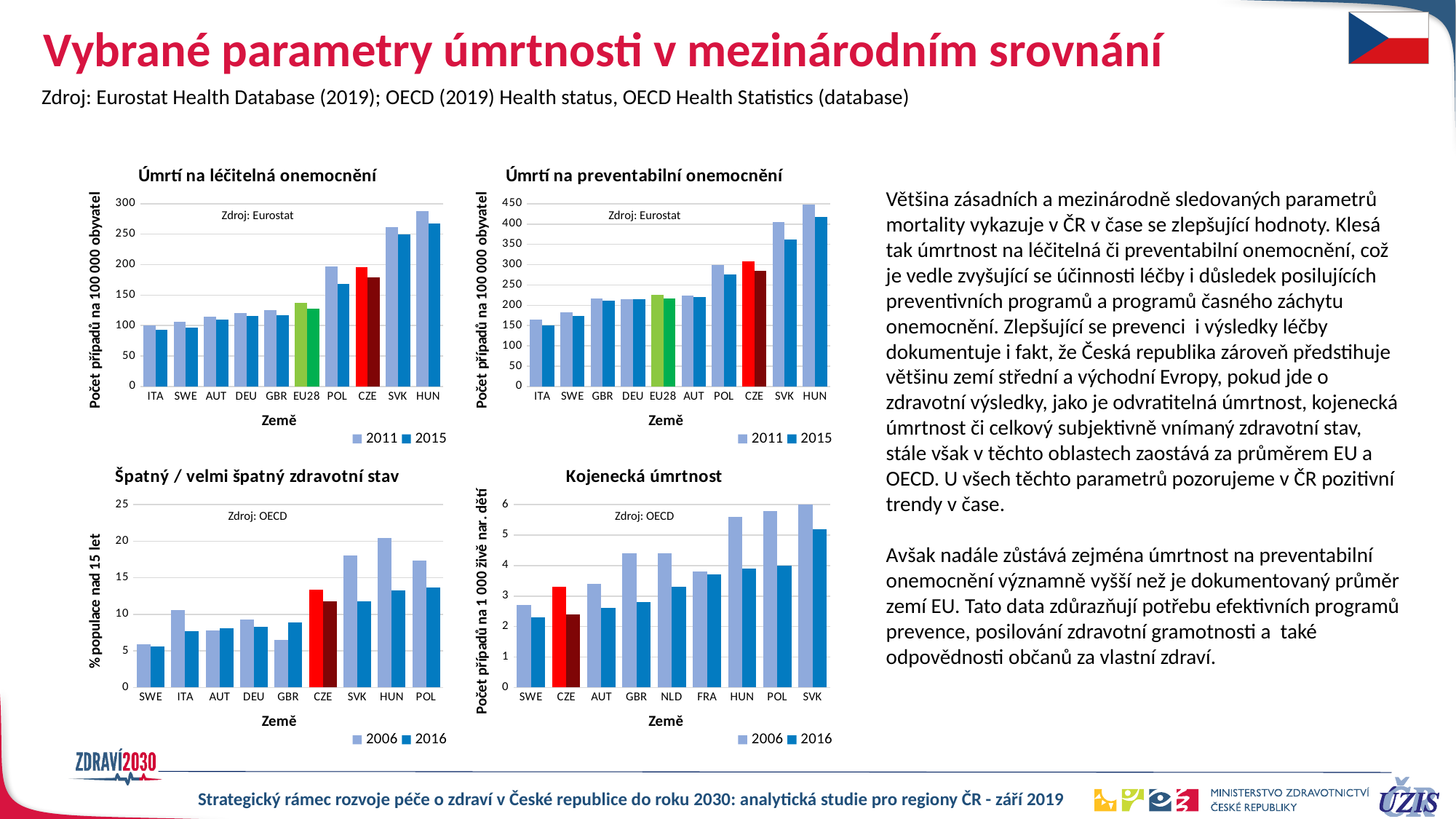
In the chart "Úmrtí na preventabilní onemocnění", is the 2015 value for SVK greater or less than 400? less In the chart "Úmrtí na léčitelná onemocnění", which country has the highest value for 2011? HUN What data source is cited inside the chart "Kojenecká úmrtnost"? OECD In the chart "Špatný / velmi špatný zdravotní stav", which country has the highest value for 2006? HUN In the chart "Úmrtí na léčitelná onemocnění", is the 2011 value for CZE greater or less than 150? greater In the chart "Úmrtí na preventabilní onemocnění", which country has the lowest value for 2015? ITA How many series does the legend of "Úmrtí na preventabilní onemocnění" list? 2 In the chart "Úmrtí na léčitelná onemocnění", how many countries/regions are shown on the x axis? 10 In the chart "Úmrtí na preventabilní onemocnění", do the 2011 values generally rise or fall from ITA to HUN along the x axis? rise In the chart "Špatný / velmi špatný zdravotní stav", which is larger for CZE: the 2006 value or the 2016 value? 2006 What kind of chart is "Úmrtí na léčitelná onemocnění"? bar chart In the chart "Kojenecká úmrtnost", is the 2016 value for CZE greater or less than 3? less